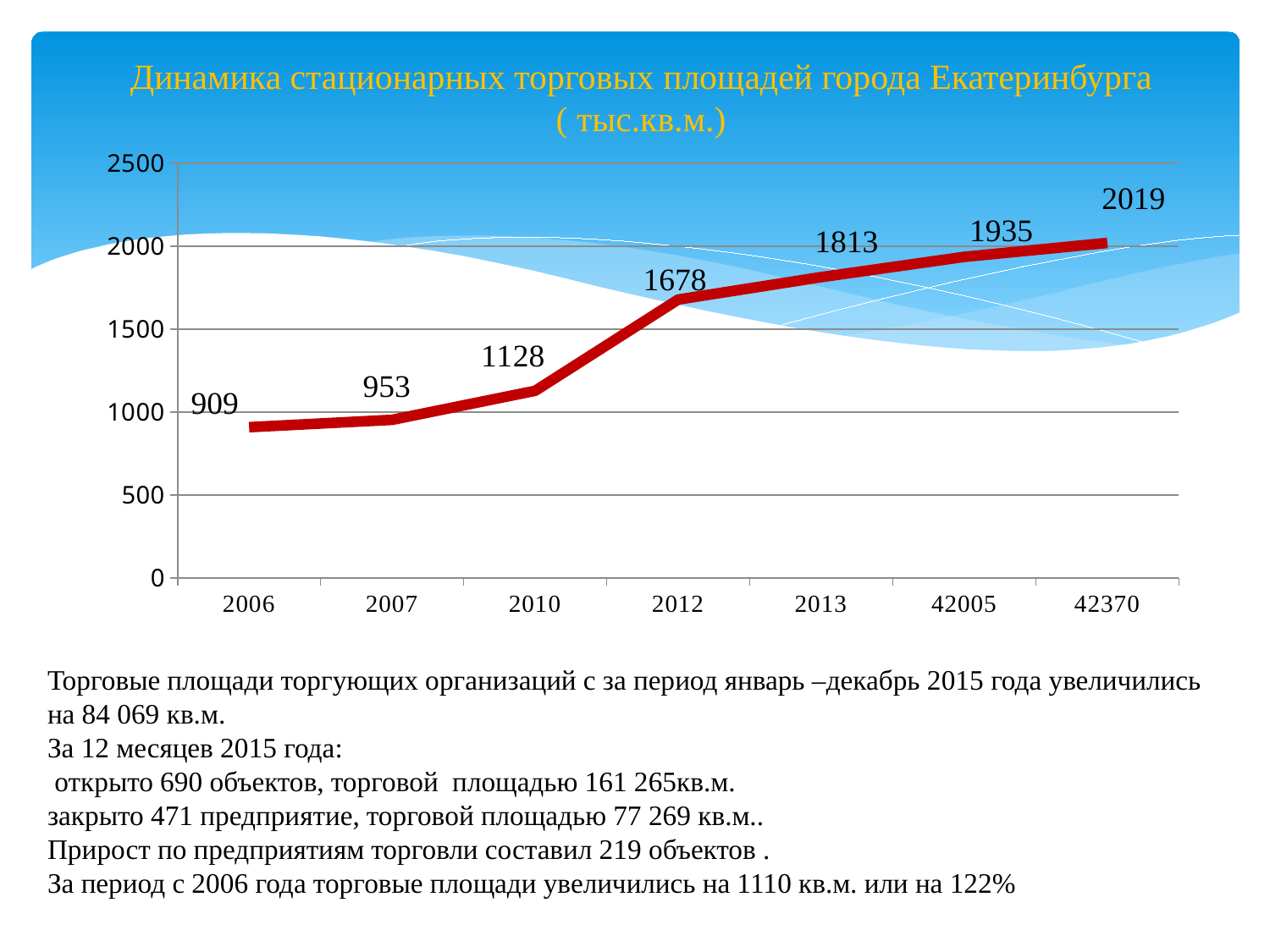
Do the values rise or fall from left to right along the x axis? rise Which is larger, the value for 2007 or the value for 2010? 2010 What is the value for the category labelled 42370? 2019 What is the value for 2012? 1678 What kind of chart is shown on the slide? line chart What is the value for 2013? 1813 What is the value for 2006? 909 Which category has the lowest value? 2006 What is the difference between the values for 2012 and 2010? 550 Which category has the highest value? 42370 Is the value for 2013 greater or less than 1500? greater How many data points are plotted on the chart? 7